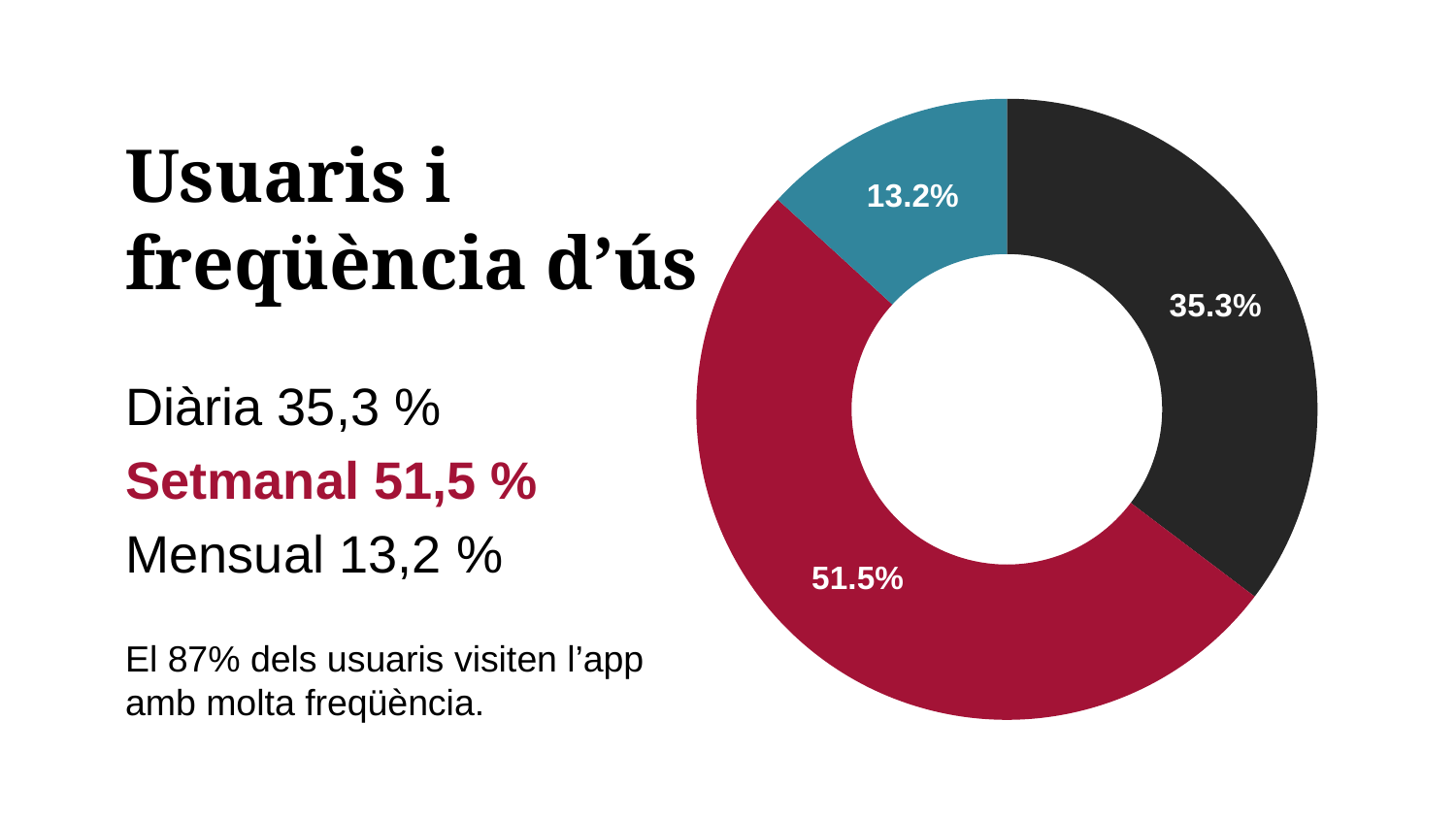
What value is printed on the smallest slice of the donut chart? 13.2% Which is larger in the donut chart, the black slice or the teal slice? The black slice (35.3%) What is the combined share of the 35.3% and 51.5% slices? 86.8% What value is printed on the largest slice of the donut chart? 51.5% What percentage is shown on the red slice of the donut chart? 51.5% According to the slide text, which usage frequency corresponds to the 51.5% slice? Setmanal What percentage is shown on the teal slice of the donut chart? 13.2% What is the difference in percentage points between the 51.5% slice and the 35.3% slice? 16.2 What kind of chart is shown on the slide? Donut (pie) chart What percentage is shown on the black slice of the donut chart? 35.3% What colour is the slice labelled 13.2%? Teal How many slices does the donut chart have? 3